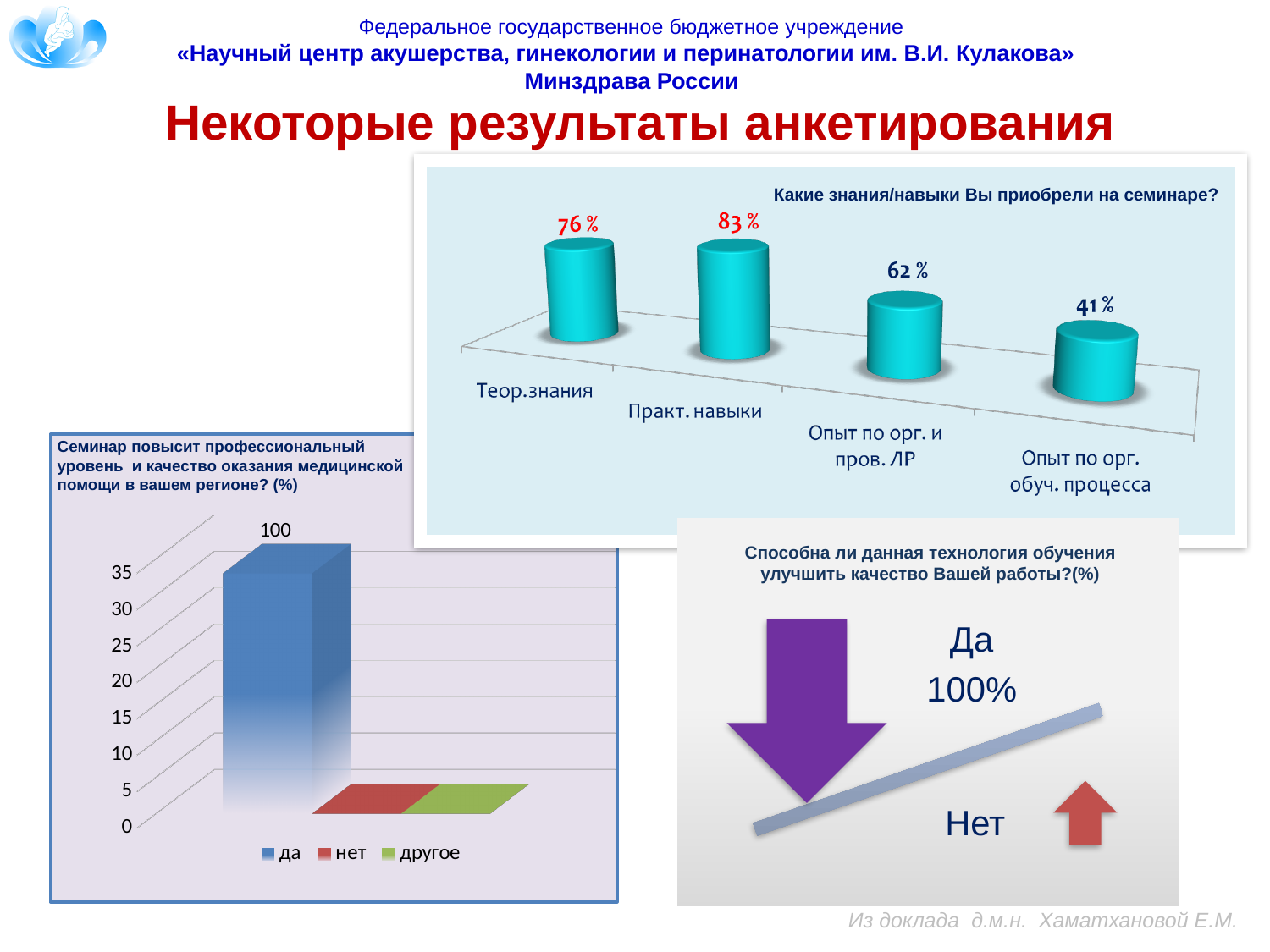
In the chart 'Какие знания/навыки Вы приобрели на семинаре?', what is the value for 'Практ. навыки'? 83 % How many categories are shown in the chart 'Какие знания/навыки Вы приобрели на семинаре?'? 4 In the chart 'Какие знания/навыки Вы приобрели на семинаре?', which category has the highest value? Практ. навыки In the chart 'Какие знания/навыки Вы приобрели на семинаре?', what is the value for 'Опыт по орг. обуч. процесса'? 41 % How many entries does the legend of the bottom-left chart 'Семинар повысит профессиональный уровень...' list? 3 In the chart 'Какие знания/навыки Вы приобрели на семинаре?', what is the difference between the values for 'Практ. навыки' and 'Опыт по орг. и пров. ЛР'? 21 % In the chart 'Какие знания/навыки Вы приобрели на семинаре?', what is the value for 'Теор.знания'? 76 % In the chart 'Какие знания/навыки Вы приобрели на семинаре?', which is larger: 'Теор.знания' or 'Опыт по орг. и пров. ЛР'? Теор.знания In the bottom-left chart 'Семинар повысит профессиональный уровень и качество оказания медицинской помощи в вашем регионе? (%)', what is the value labelled for 'да'? 100 In the chart 'Какие знания/навыки Вы приобрели на семинаре?', which category has the lowest value? Опыт по орг. обуч. процесса In the bottom-left chart 'Семинар повысит профессиональный уровень...', what colour is the 'нет' series in the legend? Red What kind of chart is 'Какие знания/навыки Вы приобрели на семинаре?'? Bar chart